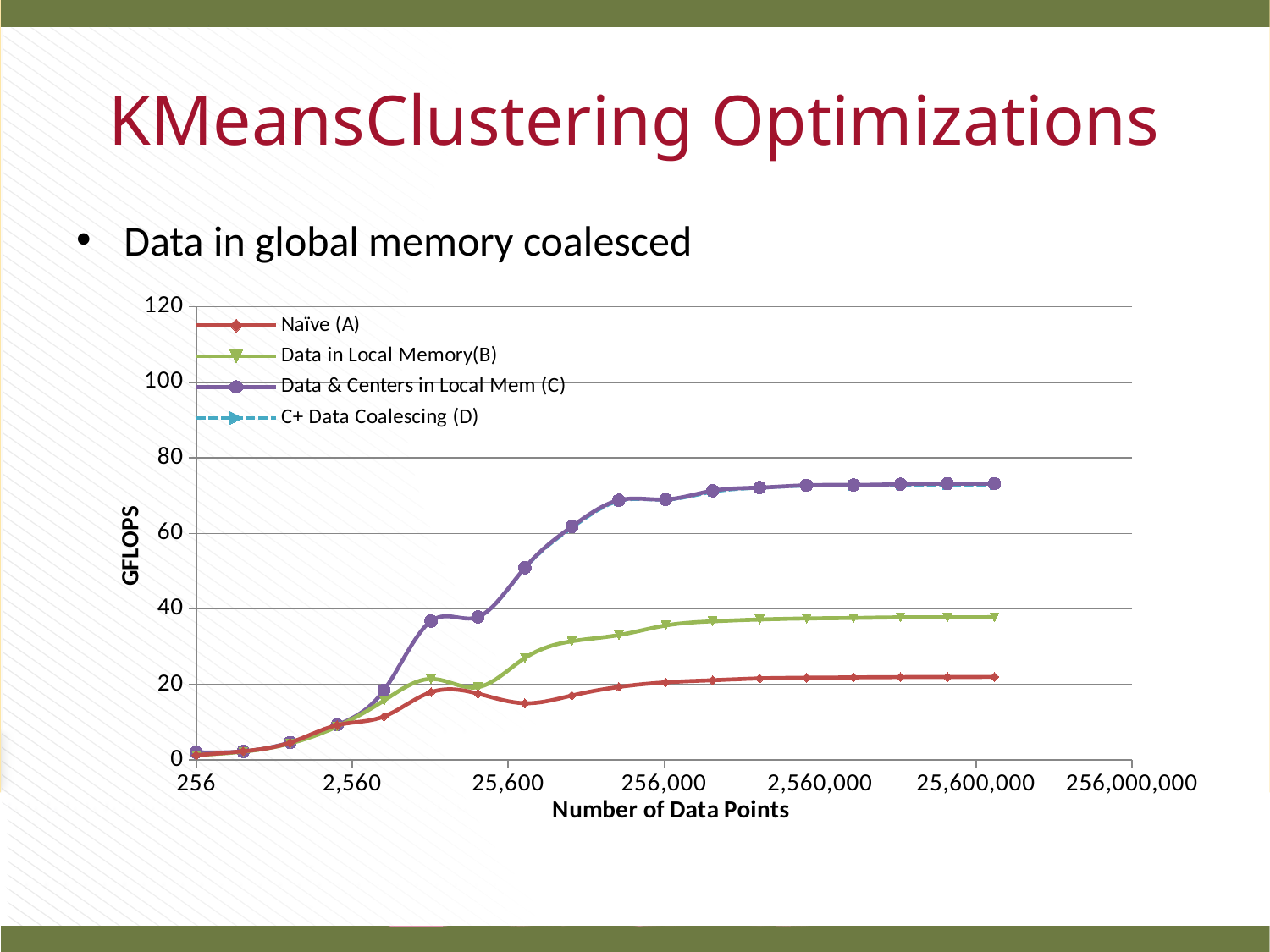
How many series does the chart's legend list? 4 Is the value for Data & Centers in Local Mem (C) at 25,600,000 data points greater or less than 80? less What kind of chart is shown on the slide? line chart Is the value for Data in Local Memory(B) at 25,600,000 data points greater or less than 40? less What is the label of the x axis of the chart? Number of Data Points Do the values for Data in Local Memory(B) generally rise or fall as the number of data points increases from 256 to 25,600,000? rise Is the value for Data & Centers in Local Mem (C) at 25,600,000 data points greater or less than 60? greater Which series has the lowest value at 25,600,000 data points? Naïve (A) At 256,000 data points, which is larger: Data & Centers in Local Mem (C) or Data in Local Memory(B)? Data & Centers in Local Mem (C) What is the label of the y axis of the chart? GFLOPS